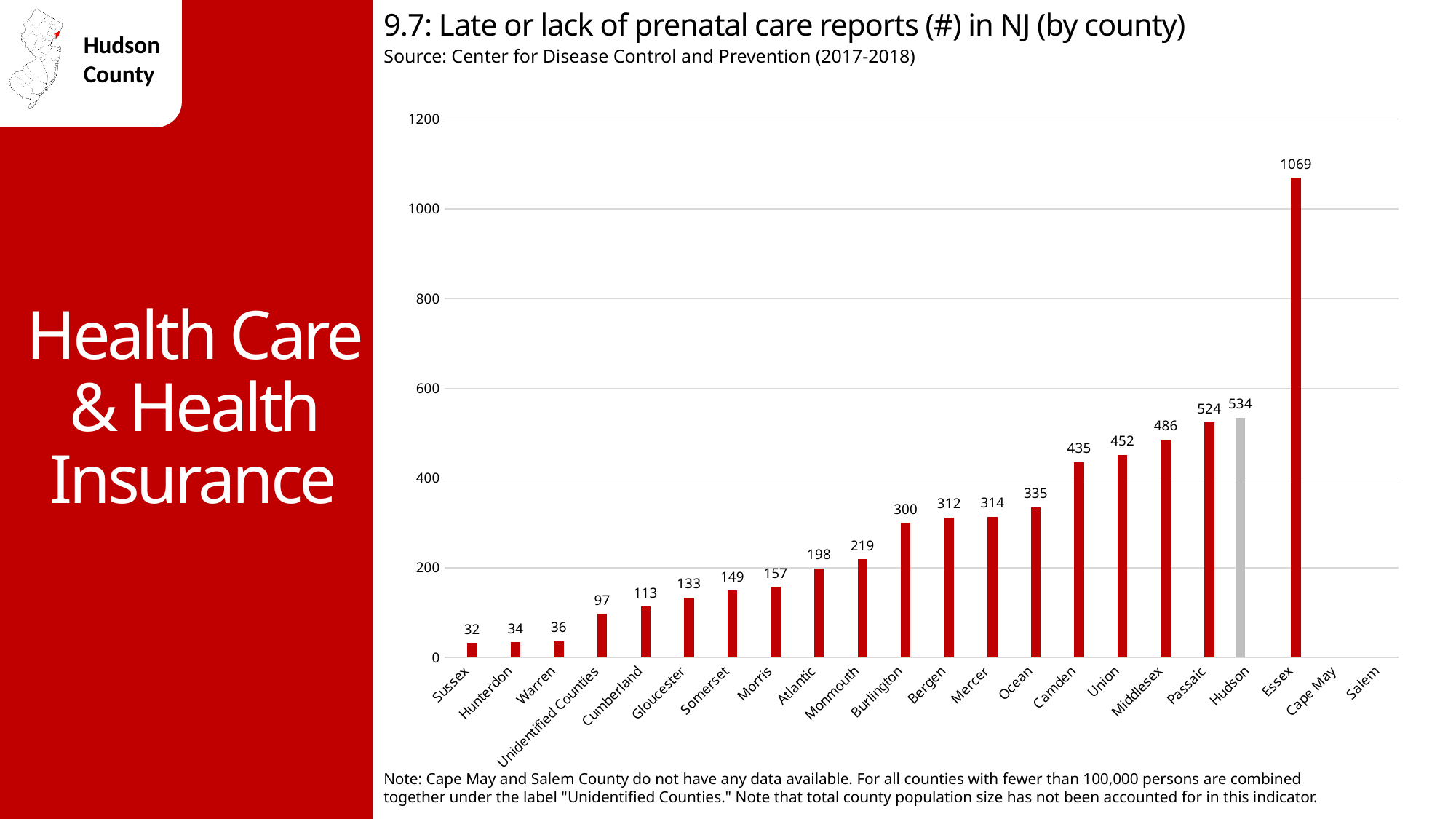
Which county's bar is coloured grey instead of red? Hudson How many county labels are shown on the x axis? 22 What is the number of late or lack of prenatal care reports for Hudson County? 534 Is the value for Essex greater or less than 1000? greater What is the value shown for Unidentified Counties? 97 What is the value shown for Essex County? 1069 Which has a larger value, Camden or Bergen? Camden Do the values generally rise or fall from Sussex to Essex along the x axis? Rise What kind of chart is shown on the slide? Bar chart Which county has the highest number of late or lack of prenatal care reports? Essex What is the difference between the values for Essex and Hudson? 535 Which county has the lowest number of reports among those with data? Sussex